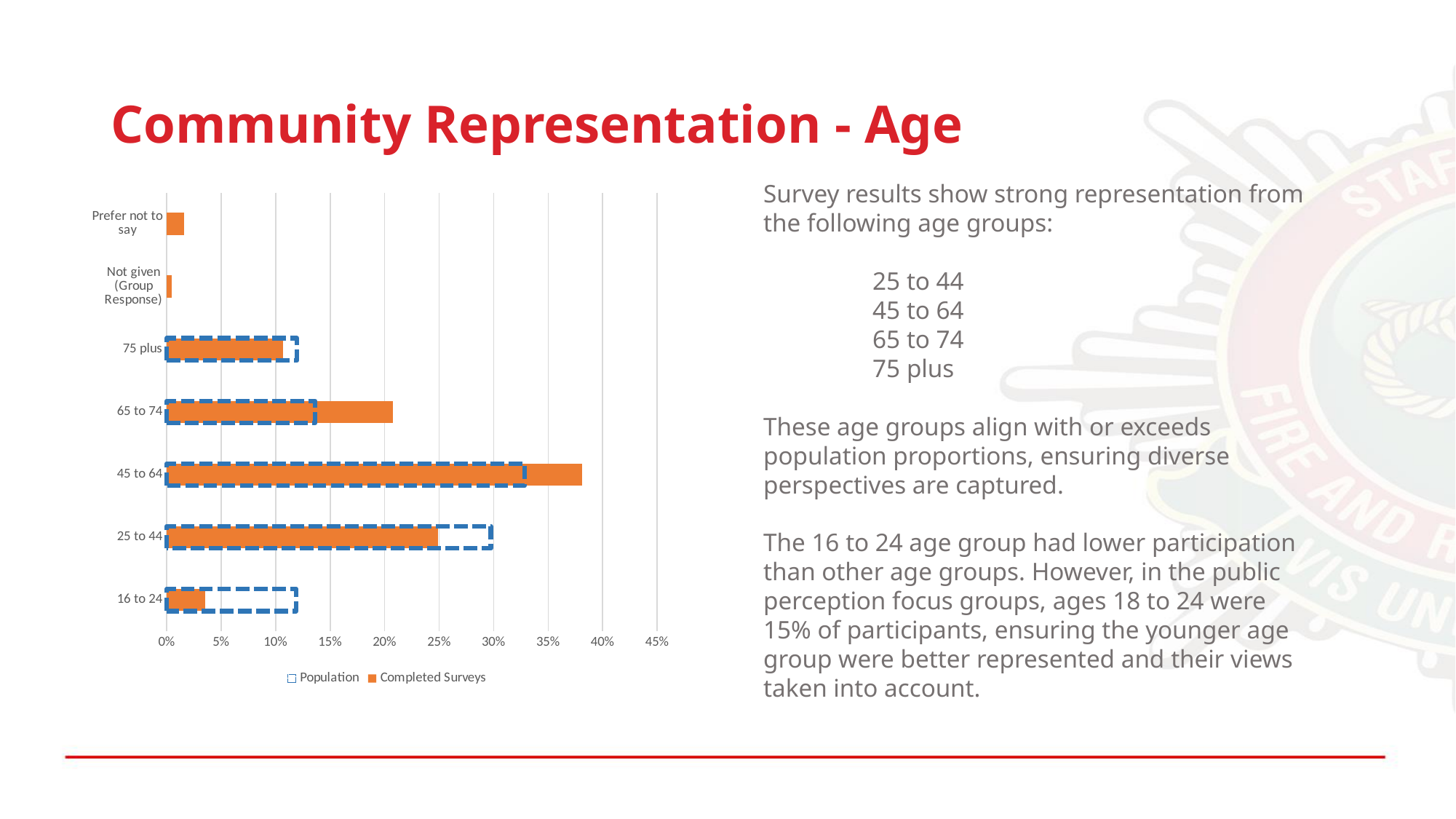
Which category has the highest Completed Surveys value? 45 to 64 How many categories are shown on the chart's vertical axis? 7 Which series is shown with a dashed blue outline in the legend? Population Is the Completed Surveys value for 45 to 64 greater or less than 35%? greater Which category has the lowest Completed Surveys value? Not given (Group Response) Is the Population value for 25 to 44 greater or less than 25%? greater For the 65 to 74 age group, which is larger: Population or Completed Surveys? Completed Surveys How many series does the chart legend list? 2 Is the Completed Surveys value for 16 to 24 greater or less than 5%? less For the 25 to 44 age group, which is larger: Population or Completed Surveys? Population Which category has the highest Population value? 45 to 64 What kind of chart is shown on the slide? Bar chart